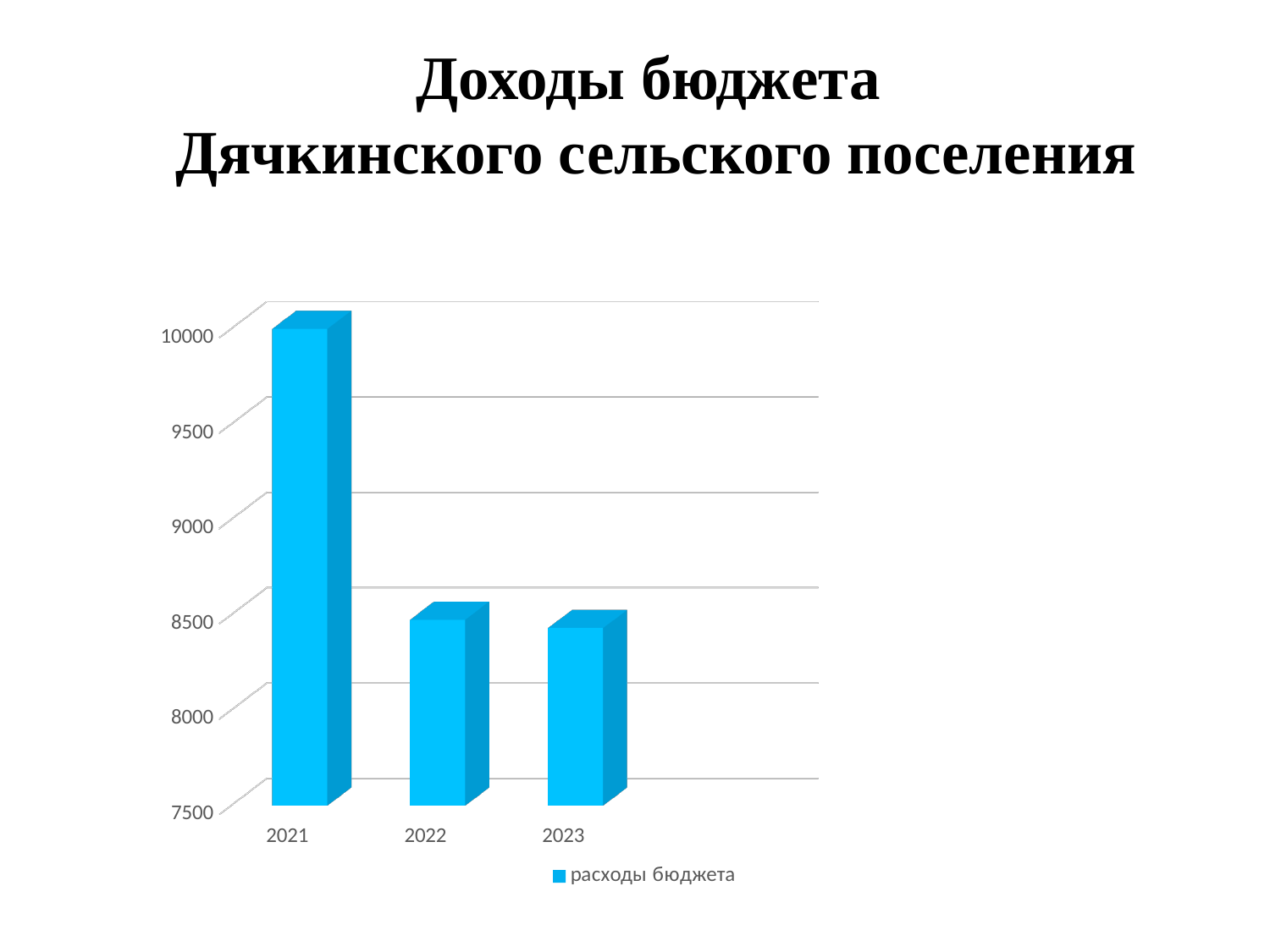
How many years (categories) are shown on the x axis? 3 How many series does the legend list? 1 Which is larger, the value for 2021 or the value for 2023? 2021 What is the title of the slide? Доходы бюджета Дячкинского сельского поселения What series name is shown in the legend? расходы бюджета What kind of chart is shown on the slide? bar chart Is the value for 2022 greater or less than 9000? less Which year has the highest value? 2021 Is the value for 2021 greater or less than 9500? greater Do the values rise or fall from 2021 to 2023? fall Is the value for 2022 greater or less than 8000? greater